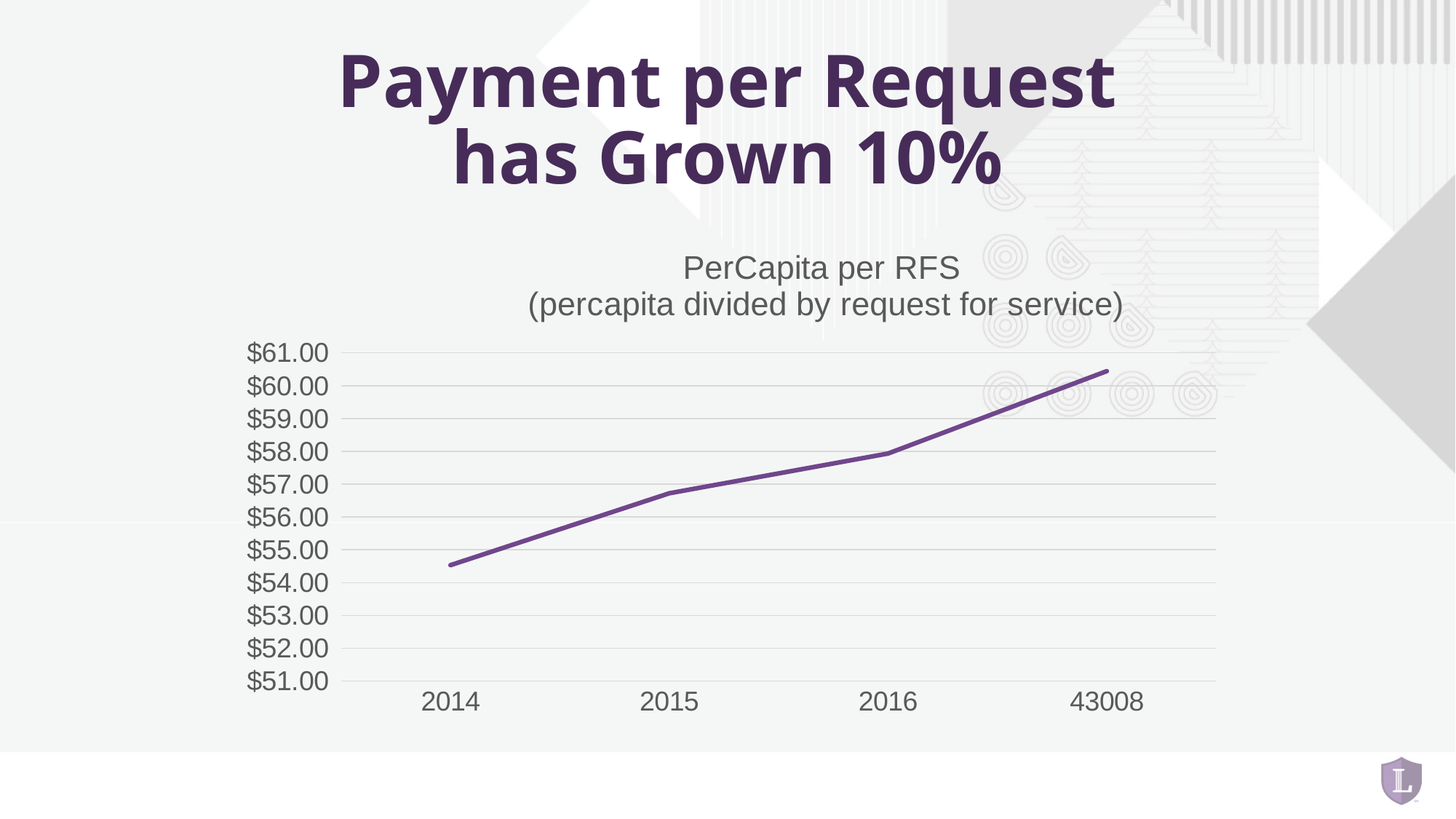
Is the value for 2015 greater or less than $56.00? greater What is the title of the chart? PerCapita per RFS (percapita divided by request for service) Is the value for 2014 greater or less than $55.00? less Do the values rise or fall from 2014 to 43008? rise What kind of chart is shown on the slide? line chart Which category has the lowest value? 2014 Which category has the highest value? 43008 What is the label of the last category on the x axis? 43008 How many points are plotted on the line? 4 Which is larger, the value for 2015 or the value for 2016? 2016 Is the value for 43008 greater or less than $60.00? greater